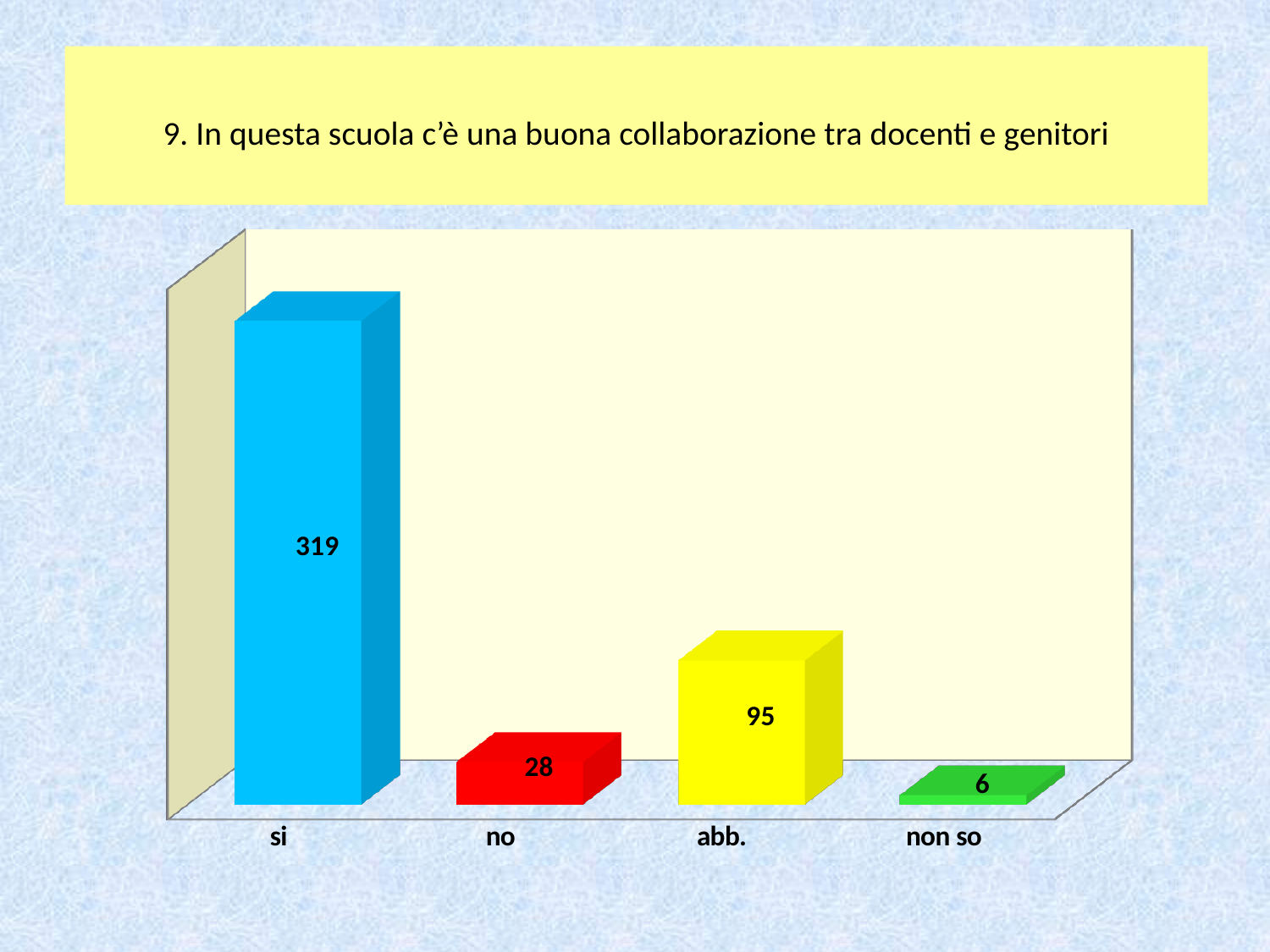
What is the value for "non so"? 6 What colour is the bar for "no"? red What is the difference between the values for "abb." and "no"? 67 How many categories are shown on the x axis? 4 What is the value for "si"? 319 What kind of chart is shown on the slide? bar chart What is the difference between the values for "si" and "abb."? 224 Which category has the highest value? si What is the value for "no"? 28 Which category has the lowest value? non so What is the value for "abb."? 95 Which is larger, the value for "no" or the value for "abb."? abb.